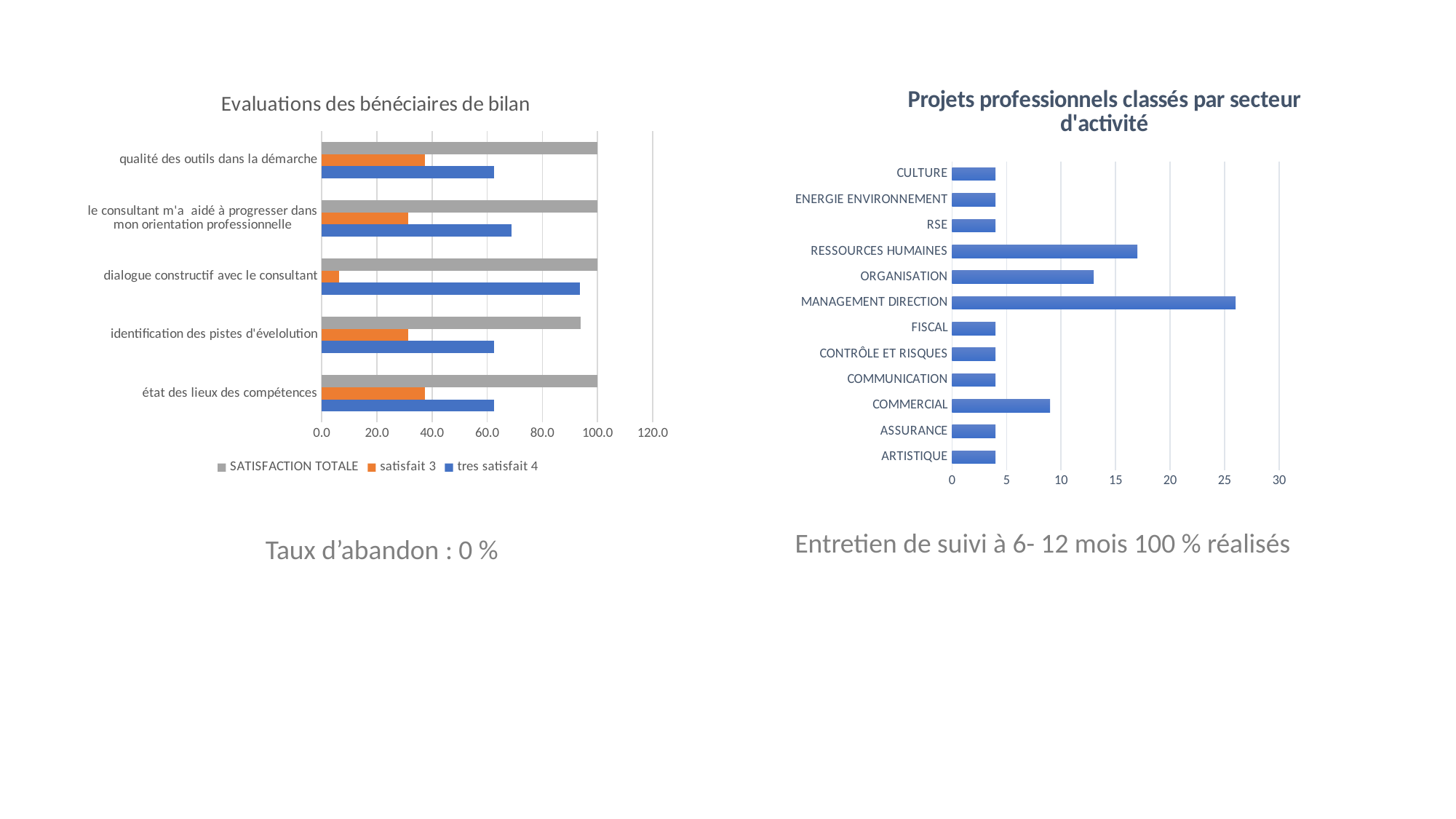
How many categories are shown in the chart 'Evaluations des bénéciaires de bilan'? 5 In the chart 'Projets professionnels classés par secteur d'activité', is the value for COMMERCIAL greater or less than 10? less In the chart 'Evaluations des bénéciaires de bilan', for 'dialogue constructif avec le consultant', which is larger: 'satisfait 3' or 'tres satisfait 4'? tres satisfait 4 In the chart 'Projets professionnels classés par secteur d'activité', is the value for MANAGEMENT DIRECTION greater or less than 20? greater In the chart 'Projets professionnels classés par secteur d'activité', which sector has the highest value? MANAGEMENT DIRECTION In the chart 'Evaluations des bénéciaires de bilan', which colour represents the series 'satisfait 3'? orange In the chart 'Projets professionnels classés par secteur d'activité', is the value for RESSOURCES HUMAINES greater or less than 15? greater What kind of chart is 'Projets professionnels classés par secteur d'activité'? bar chart How many series does the legend of the chart 'Evaluations des bénéciaires de bilan' list? 3 How many sectors are shown in the chart 'Projets professionnels classés par secteur d'activité'? 12 In the chart 'Projets professionnels classés par secteur d'activité', which is larger: RESSOURCES HUMAINES or ORGANISATION? RESSOURCES HUMAINES